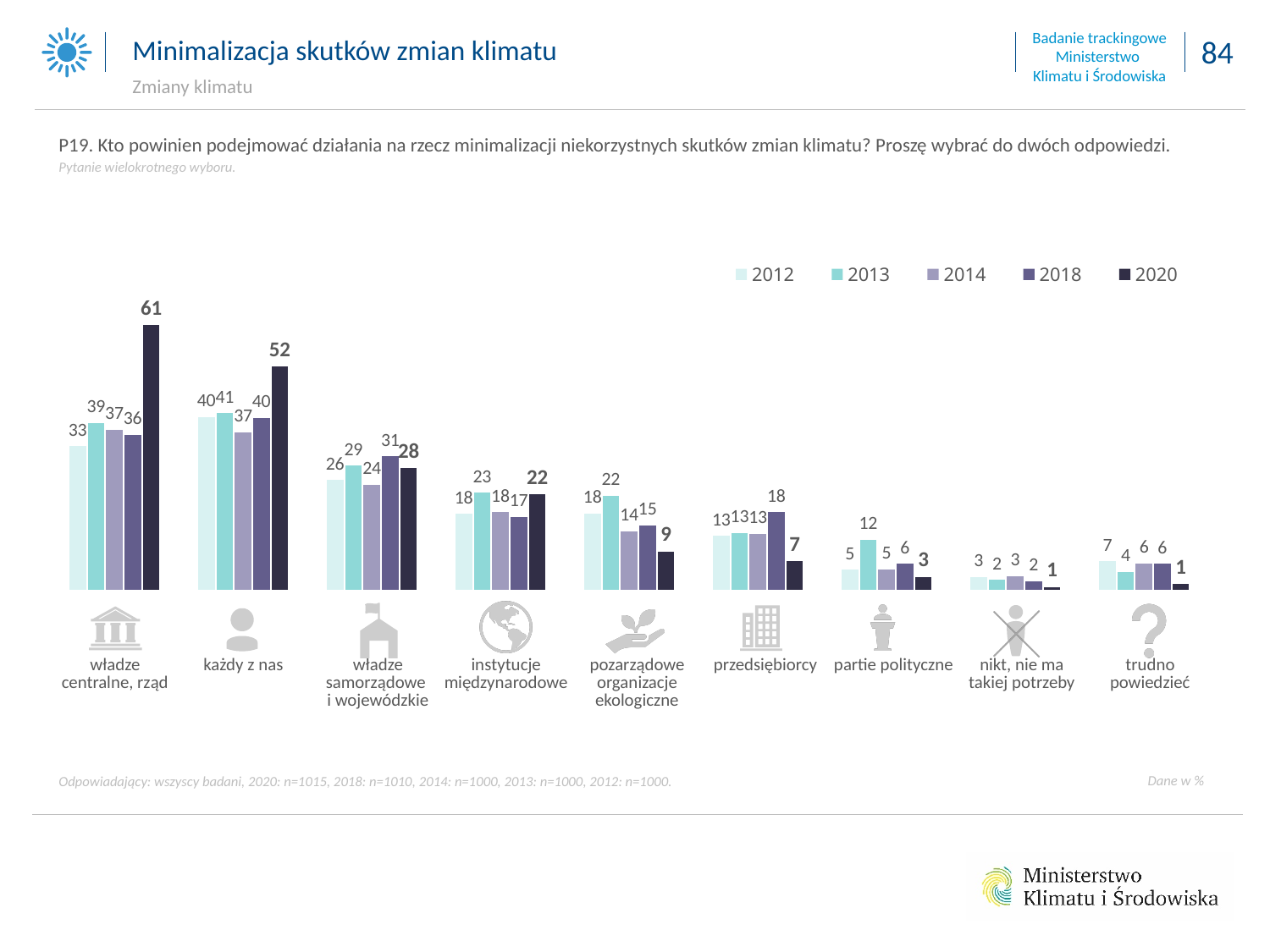
How many categories are shown on the x axis? 9 Which category has the highest 2020 value? władze centralne, rząd Which category has the lowest 2012 value? nikt, nie ma takiej potrzeby Which years are listed in the legend? 2012, 2013, 2014, 2018, 2020 What is the 2018 value for "przedsiębiorcy"? 18 Which is larger for "partie polityczne": the 2013 value or the 2020 value? 2013 What is the 2020 value for "władze centralne, rząd"? 61 What is the difference between the 2020 and 2018 values for "władze centralne, rząd"? 25 What is the 2013 value for "pozarządowe organizacje ekologiczne"? 22 What kind of chart is shown on the slide? bar chart What is the difference between the 2020 values for "każdy z nas" and "władze samorządowe i wojewódzkie"? 24 How many series does the legend list? 5